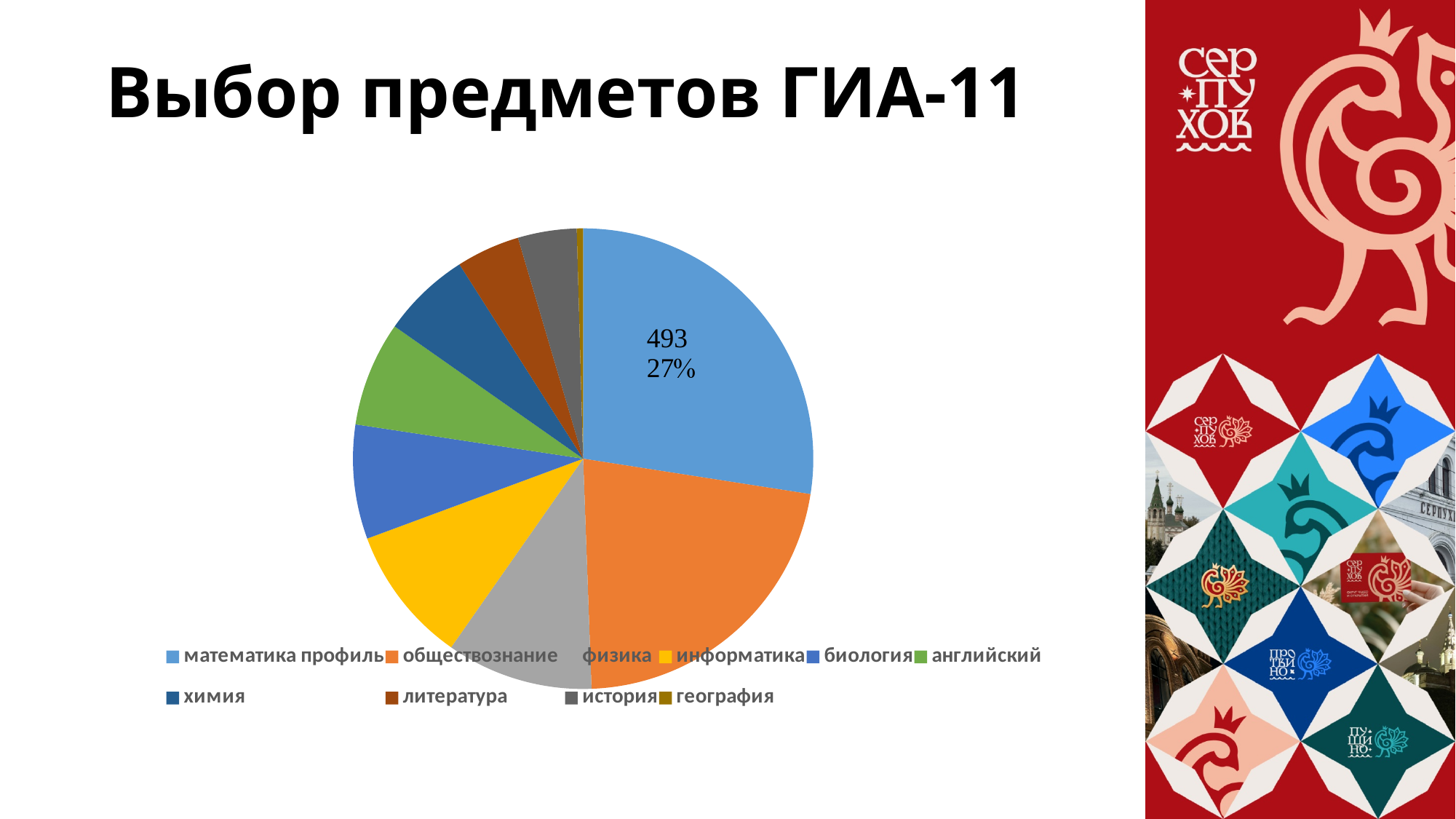
Which slice is larger: биология or литература? биология Which subject has the largest slice of the pie? математика профиль Which slice is larger: информатика or история? информатика What kind of chart is shown on the slide? pie chart How many subjects (slices) does the pie chart legend list? 10 What colour is the slice for математика профиль? light blue What value is printed on the slice for математика профиль? 493 Which slice is larger: обществознание or физика? обществознание What share of the pie does математика профиль take? 27% What is the title of the slide with the pie chart? Выбор предметов ГИА-11 Which subject has the smallest slice of the pie? география